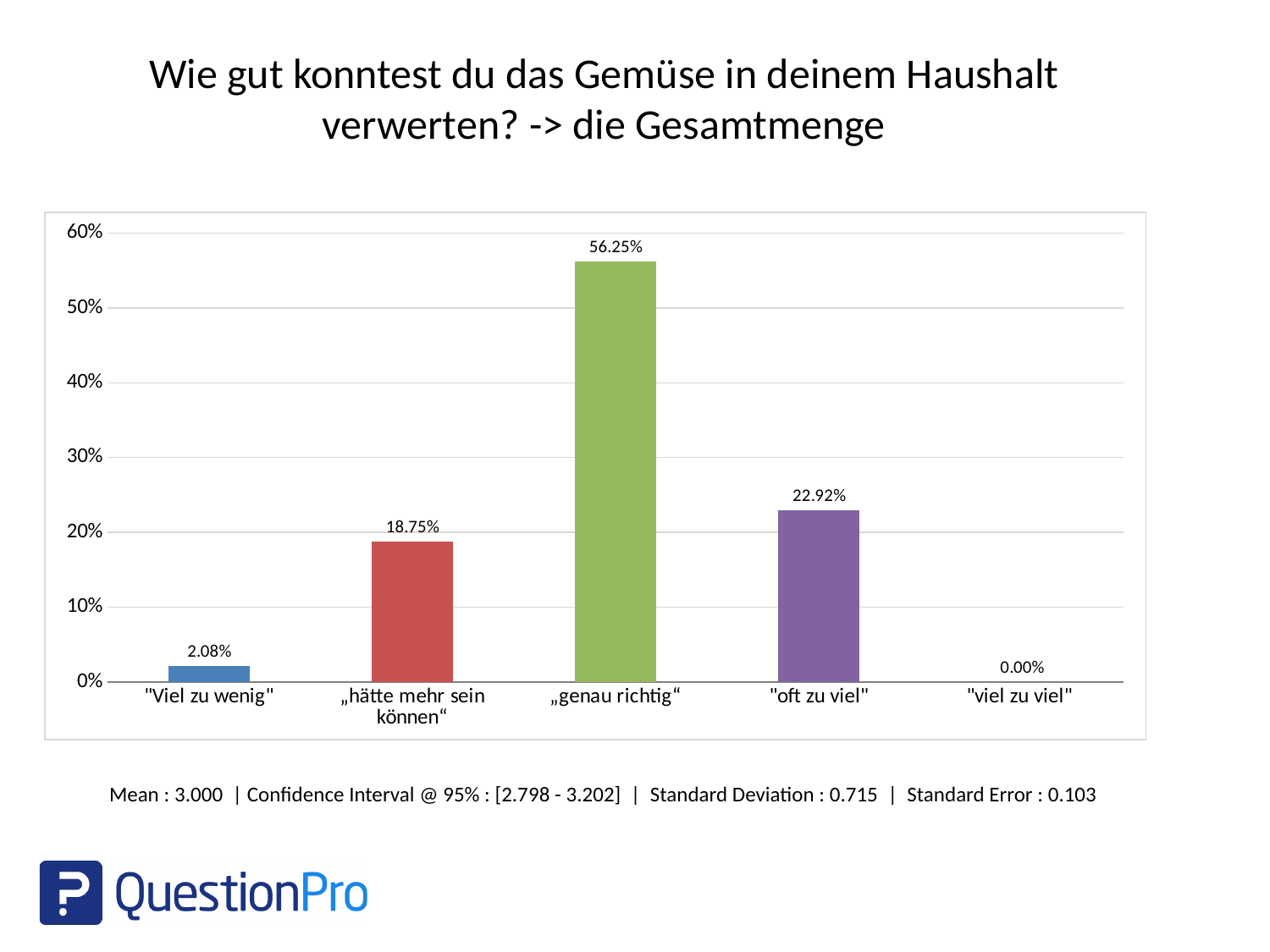
Which is larger, the value for "oft zu viel" or the value for "hätte mehr sein können"? "oft zu viel" What is the value for "oft zu viel"? 22.92% What is the value for "genau richtig"? 56.25% What is the value for "Viel zu wenig"? 2.08% What is the value for "viel zu viel"? 0.00% What kind of chart is shown on the slide? bar chart How many categories are shown on the x axis? 5 Is the value for "genau richtig" greater or less than 50%? greater Which category has the highest value? "genau richtig" What is the difference between the values for "genau richtig" and "oft zu viel"? 33.33% What is the value for "hätte mehr sein können"? 18.75% Which category has the lowest value? "viel zu viel"